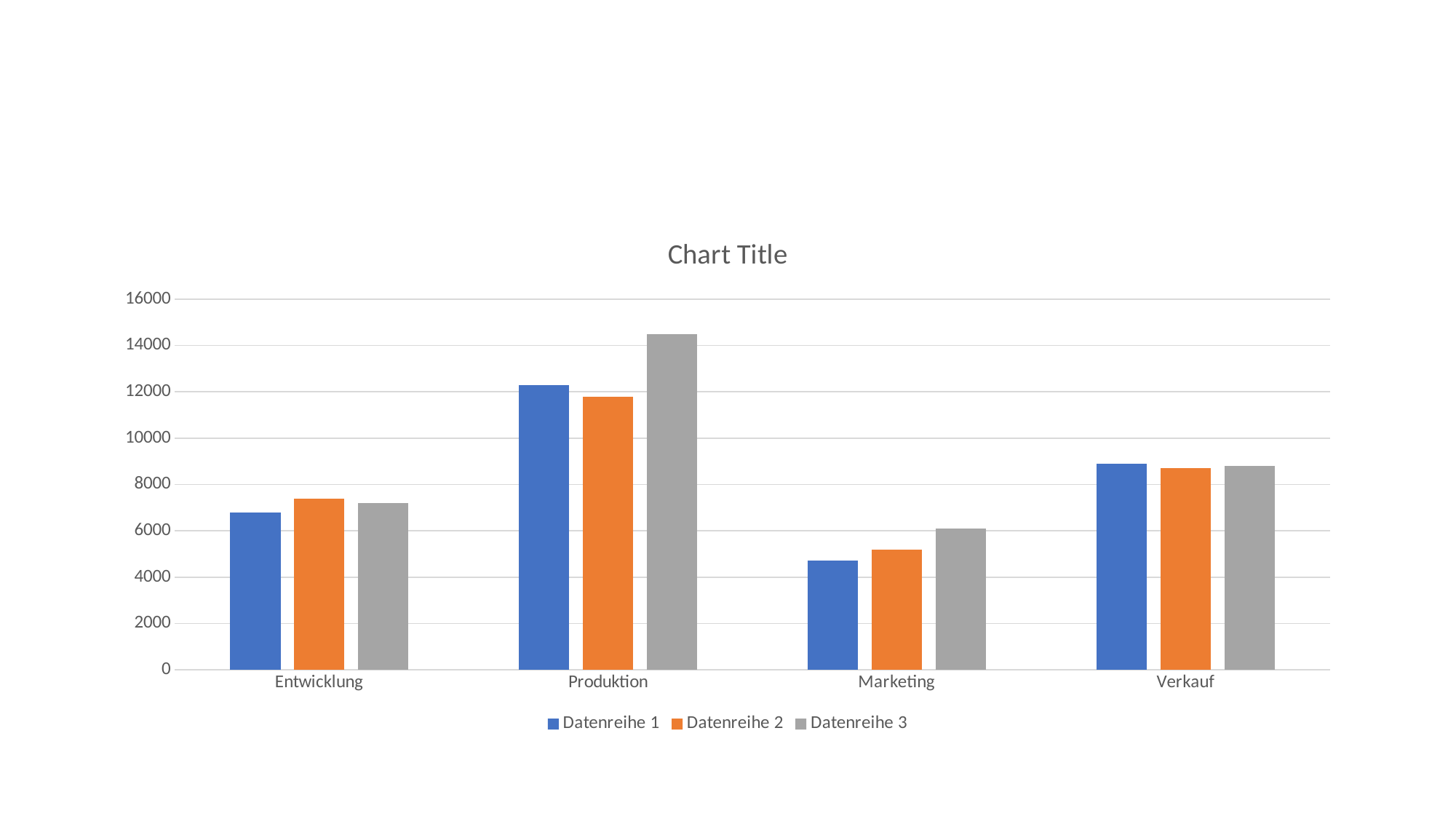
In Produktion, which is larger: Datenreihe 1 or Datenreihe 3? Datenreihe 3 How many series does the legend list? 3 What kind of chart is shown on the slide? bar chart In Marketing, which is larger: Datenreihe 1 or Datenreihe 3? Datenreihe 3 Which category has the highest value for Datenreihe 3? Produktion How many categories are shown on the x axis? 4 What is the title of the chart? Chart Title Is the value for Datenreihe 1 in Marketing greater or less than 6000? less Is the value for Datenreihe 2 in Produktion greater or less than 10000? greater Is the value for Datenreihe 3 in Produktion greater or less than 14000? greater Which category has the lowest value for Datenreihe 1? Marketing